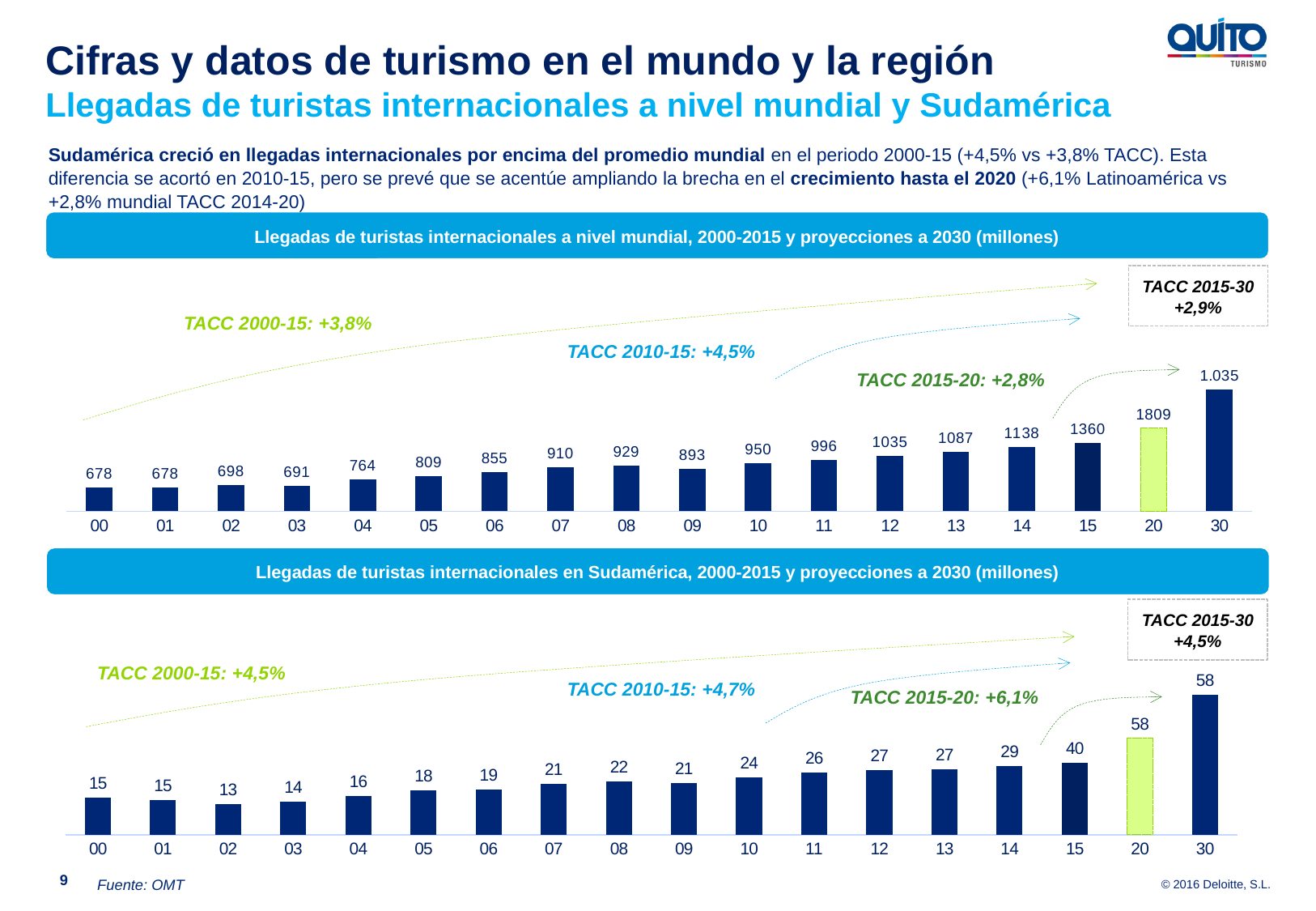
In the bottom chart (Llegadas de turistas internacionales en Sudamérica), do the values generally rise or fall from 00 to 15? rise In the top chart (Llegadas de turistas internacionales a nivel mundial), what is the value for 15? 1360 In the bottom chart (Llegadas de turistas internacionales en Sudamérica), what is the value for 15? 40 In the top chart (Llegadas de turistas internacionales a nivel mundial), which is larger, the value for 08 or the value for 09? 08 In the bottom chart (Llegadas de turistas internacionales en Sudamérica), how many bars are plotted? 18 In the top chart (Llegadas de turistas internacionales a nivel mundial), what is the value for 00? 678 In the top chart (Llegadas de turistas internacionales a nivel mundial), what is the difference between the values for 15 and 14? 222 In the bottom chart (Llegadas de turistas internacionales en Sudamérica), which year has the lowest value? 02 In the bottom chart (Llegadas de turistas internacionales en Sudamérica), what TACC 2015-30 is shown in the box at the top right? +4,5% In the bottom chart (Llegadas de turistas internacionales en Sudamérica), what is the difference between the values for 15 and 14? 11 In the top chart (Llegadas de turistas internacionales a nivel mundial), what kind of chart is used? bar chart In the top chart (Llegadas de turistas internacionales a nivel mundial), how many bars are plotted? 18